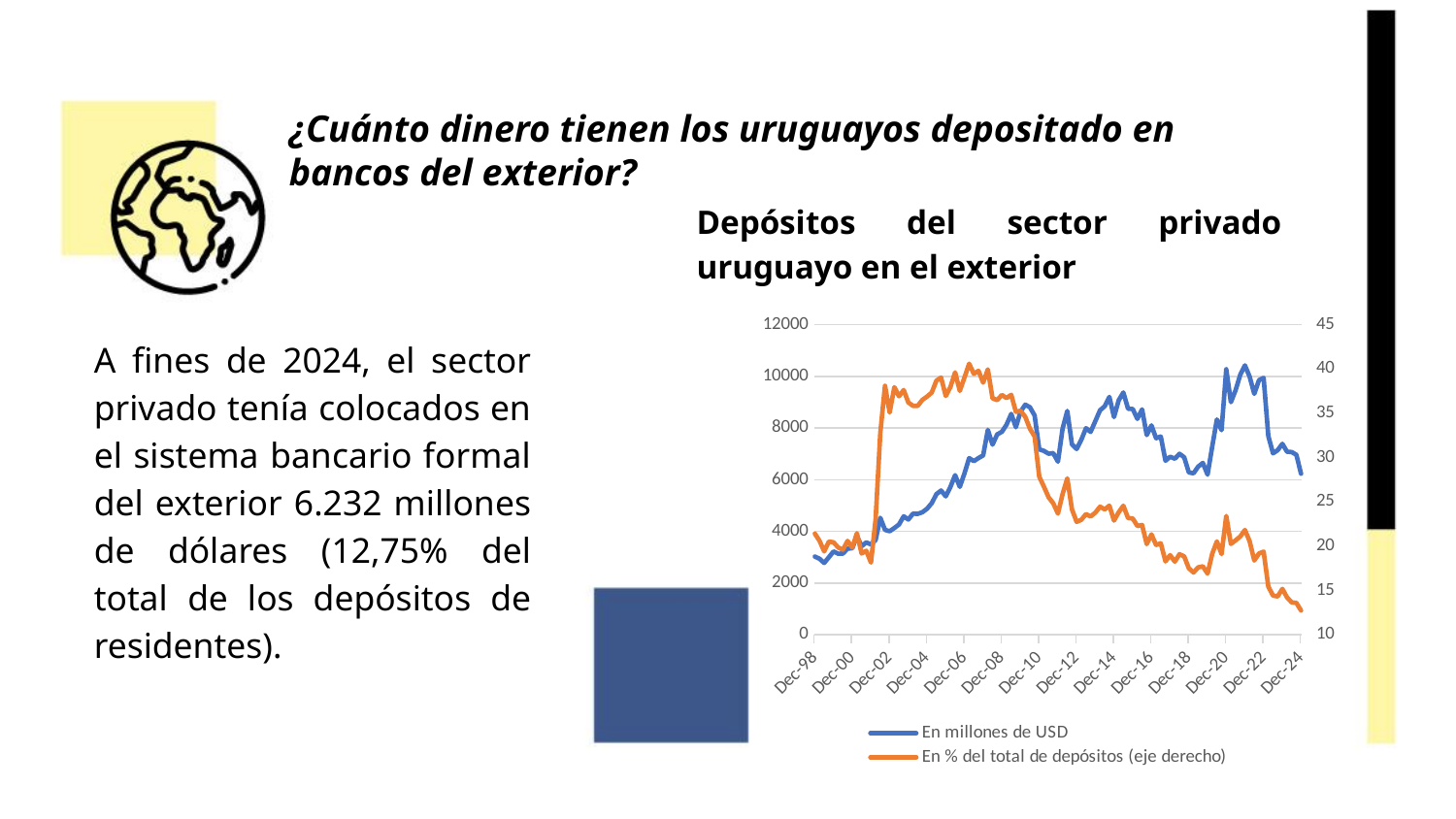
What is the title of the chart? Depósitos del sector privado uruguayo en el exterior Does the 'En % del total de depósitos' series rise or fall overall between Dec-10 and Dec-24? fall Which series in the chart is plotted against the right-hand axis? En % del total de depósitos (eje derecho) Does the 'En millones de USD' series rise or fall overall between Dec-98 and Dec-08? rise What kind of chart is shown on the slide? Line chart For the 'En millones de USD' series, is the value higher at Dec-20 or at Dec-24? Dec-20 Is the value of the 'En % del total de depósitos' series at Dec-98 greater or less than 25? less How many series does the legend of the chart list? 2 Is the value of the 'En millones de USD' series at Dec-14 greater or less than 8000? greater How many year labels are shown along the x axis of the chart? 14 Is the value of the 'En millones de USD' series at Dec-98 greater or less than 4000? less